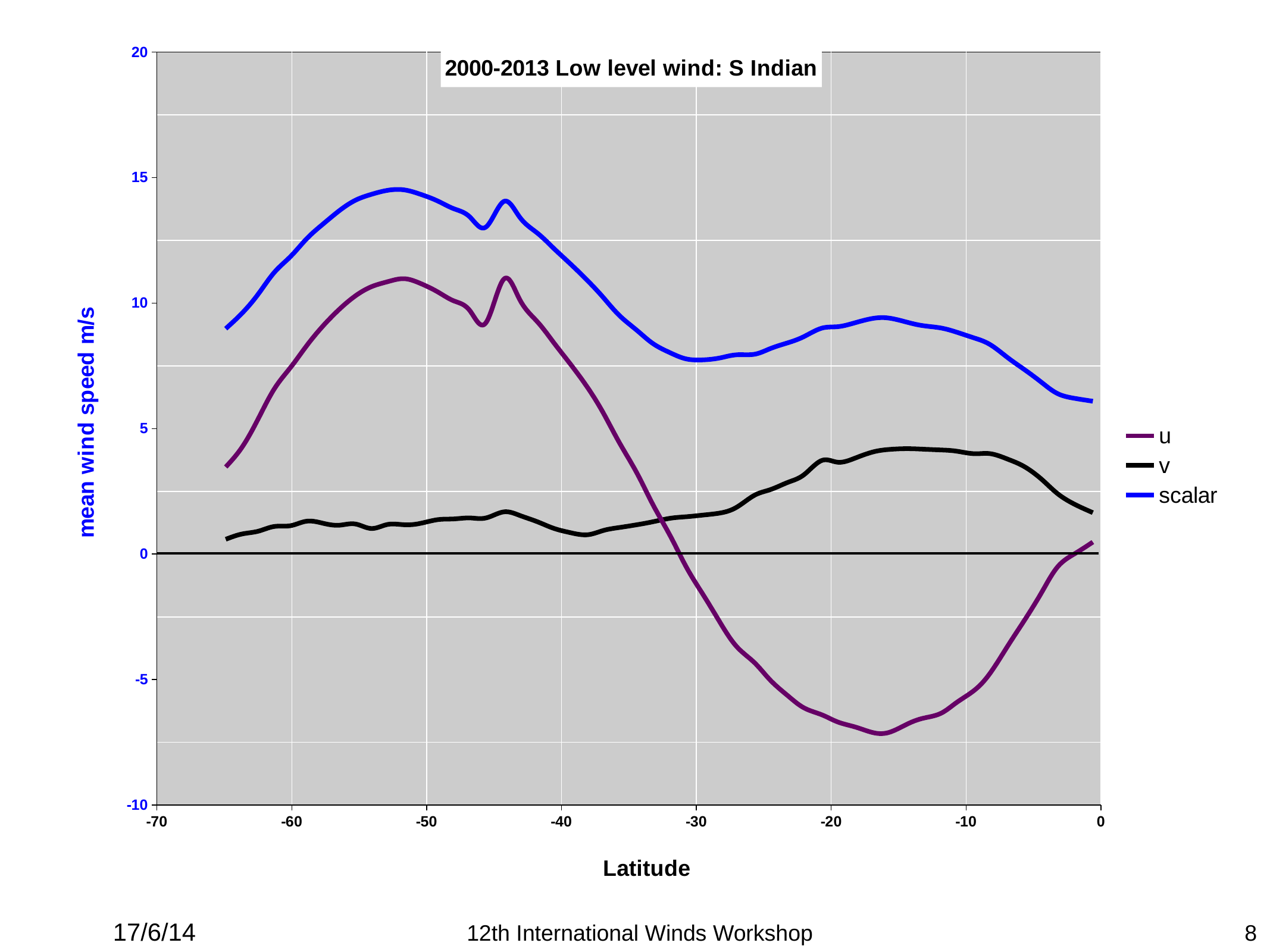
At latitude -40, which series has the larger value, scalar or u? scalar What kind of chart is shown on the slide? line chart Is the value of the v series at latitude -15 greater or less than 5? less Is the value of the scalar series at latitude -50 greater or less than 10? greater What is the title of the chart? 2000-2013 Low level wind: S Indian At latitude -20, which series has the larger value, u or v? v How many series does the legend list? 3 Is the value of the u series at latitude -20 greater or less than -5? less Does the u series rise or fall between latitude -40 and latitude -20? fall Which series has the lowest value at latitude -20? u What is the label of the y axis? mean wind speed m/s